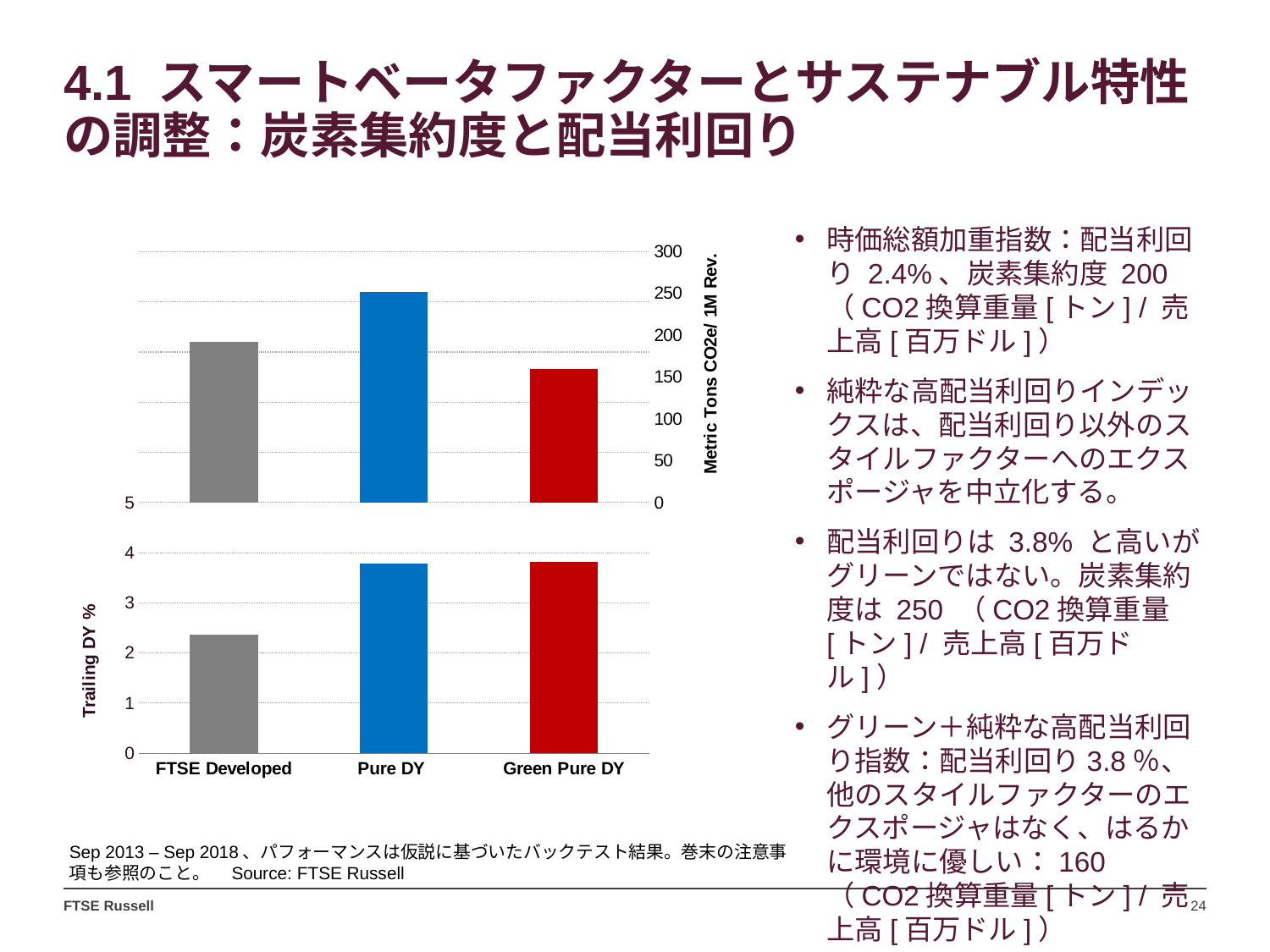
In the bottom chart (Trailing DY %), is the value for FTSE Developed greater or less than 3? less In the top chart (Metric Tons CO2e/ 1M Rev.), is the value for Pure DY greater or less than 200? greater In the bottom chart (Trailing DY %), which category has the lowest value? FTSE Developed What is the y-axis title of the bottom chart? Trailing DY % In the bottom chart (Trailing DY %), is the value for Pure DY greater or less than 3? greater How many categories are shown on the x axis of the bottom chart (Trailing DY %)? 3 In the top chart (Metric Tons CO2e/ 1M Rev.), which is larger, the value for FTSE Developed or the value for Green Pure DY? FTSE Developed What kind of chart is the top chart (Metric Tons CO2e/ 1M Rev.)? Bar chart In the top chart (Metric Tons CO2e/ 1M Rev.), which category has the lowest value? Green Pure DY In the top chart (Metric Tons CO2e/ 1M Rev.), which category has the highest value? Pure DY